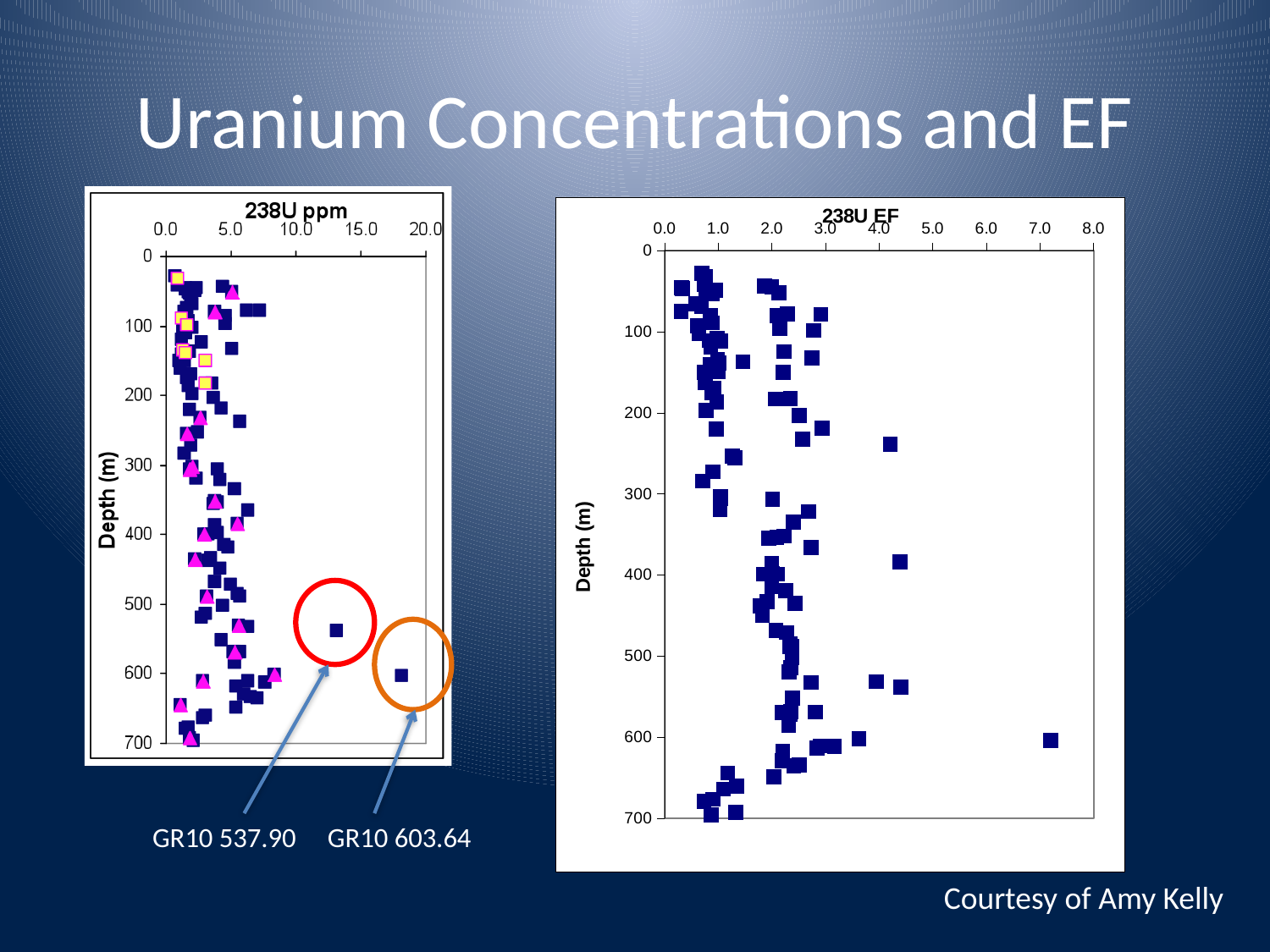
In the left chart, which sample label does the arrow from the orange circle point to? GR10 603.64 What kind of chart is the left chart titled 238U ppm? scatter chart In the left chart, which sample label does the arrow from the red circle point to? GR10 537.90 In the right chart (238U EF), is the value of the point near 240 m depth that lies to the right of the main cluster greater or less than 3.0? greater In the left chart (238U ppm), is the value of the point inside the orange circle greater or less than 15.0? greater In the left chart (238U ppm), is the value of the point inside the orange circle greater or less than the value of the point inside the red circle? greater What kind of chart is the right chart titled 238U EF? scatter chart In the right chart (238U EF), is the value of the isolated point near 600 m depth at the far right greater or less than 6.0? greater